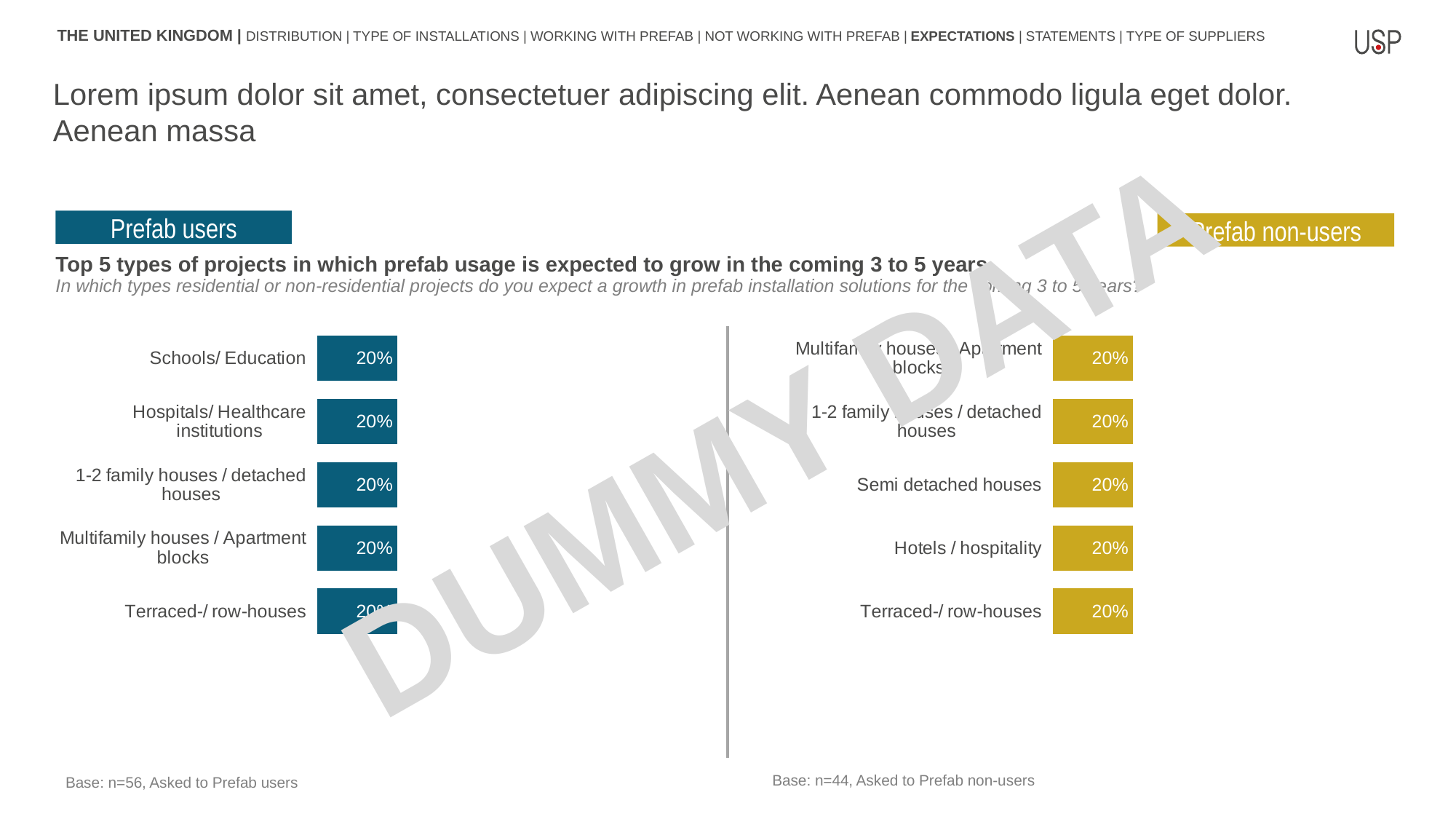
In the Prefab users chart, what is the value for Hospitals/ Healthcare institutions? 20% How many categories are shown in the Prefab users chart? 5 In the Prefab users chart, what is the value for Terraced-/ row-houses? 20% What colour are the bars in the Prefab non-users chart? Yellow/gold In the Prefab non-users chart, what is the value for 1-2 family houses / detached houses? 20% In the Prefab non-users chart, what is the value for Hotels / hospitality? 20% In the Prefab non-users chart, what is the value for Semi detached houses? 20% What is the base (n) stated for the Prefab users chart? n=56 In the Prefab users chart, what is the difference between the values for Schools/ Education and Terraced-/ row-houses? 0% How many categories are shown in the Prefab non-users chart? 5 What kind of chart is the Prefab users chart? Bar chart In the Prefab users chart, what is the value for Schools/ Education? 20%